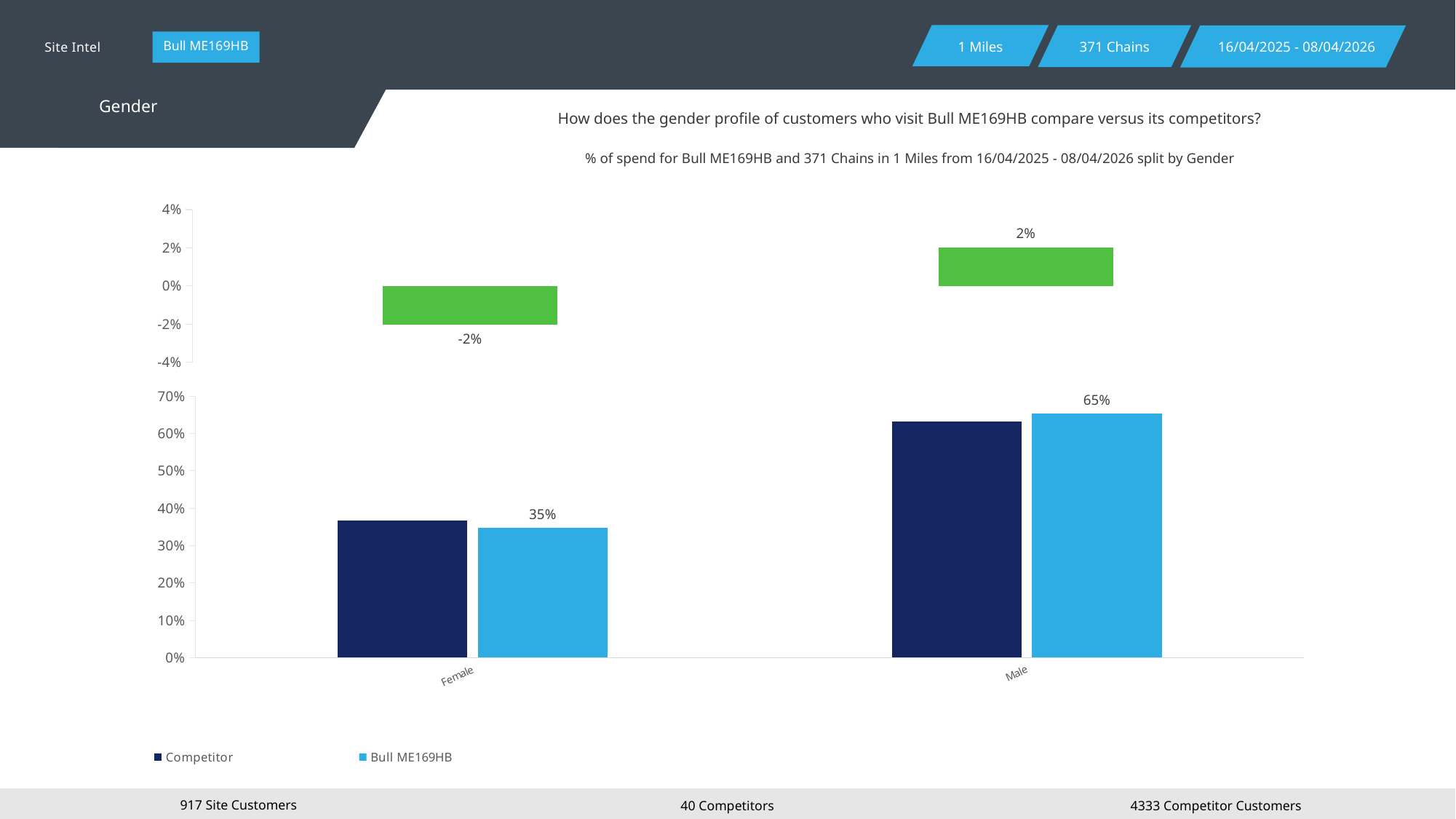
How many categories are shown on the x axis of the bottom chart? 2 In the bottom chart, is the Competitor value for Male greater or less than 60%? greater How many series does the legend of the bottom chart list? 2 In the bottom chart, what is the value for Bull ME169HB for Female? 35% In the bottom chart, is the Competitor value for Female greater or less than 30%? greater In the bottom chart, for Male, which is larger: the Competitor bar or the Bull ME169HB bar? Bull ME169HB What type of chart is the bottom chart? Bar chart In the top chart, what is the value shown for Female? -2% In the bottom chart, what is the difference between the Bull ME169HB values for Male and Female? 30% In the bottom chart, what is the value for Bull ME169HB for Male? 65% In the bottom chart, which gender category has the higher value for Bull ME169HB? Male In the top chart, what is the value shown for Male? 2%